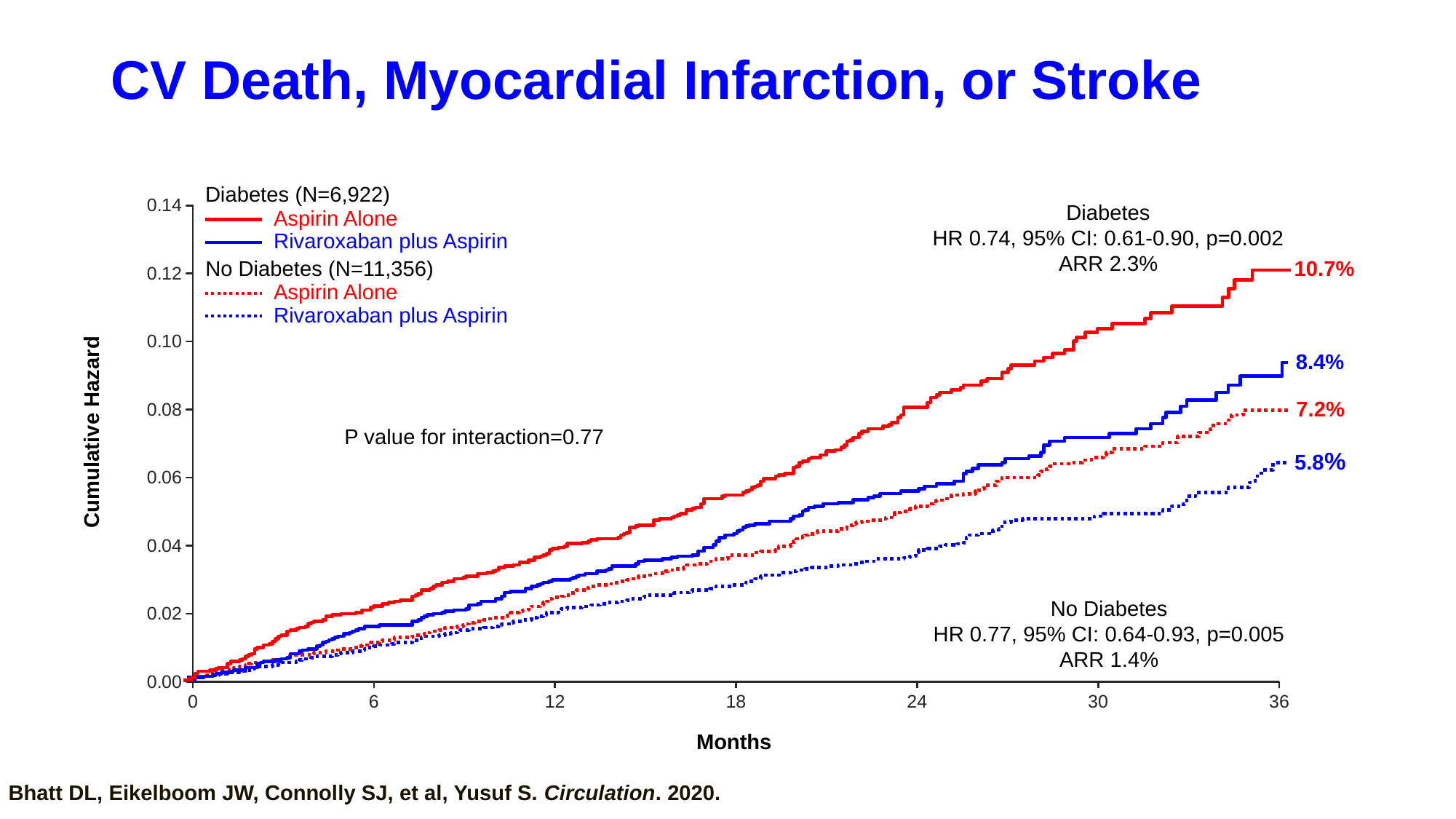
What kind of chart is shown on the slide? Line chart (cumulative hazard curves) Which curve has the highest cumulative hazard at 36 months? Diabetes, Aspirin Alone How many curves does the legend list? 4 What is the cumulative hazard at 36 months for Aspirin Alone in the Diabetes group? 10.7% What is the cumulative hazard at 36 months for Aspirin Alone in the No Diabetes group? 7.2% What is the cumulative hazard at 36 months for Rivaroxaban plus Aspirin in the Diabetes group? 8.4% What is the difference in cumulative hazard at 36 months between Aspirin Alone and Rivaroxaban plus Aspirin in the Diabetes group? 2.3% At 36 months, which is larger: the cumulative hazard for Rivaroxaban plus Aspirin in the Diabetes group or for Aspirin Alone in the No Diabetes group? Rivaroxaban plus Aspirin in the Diabetes group What is the cumulative hazard at 36 months for Rivaroxaban plus Aspirin in the No Diabetes group? 5.8% Which curve has the lowest cumulative hazard at 36 months? No Diabetes, Rivaroxaban plus Aspirin Is the cumulative hazard for the Diabetes Aspirin Alone curve at 24 months greater or less than 0.06? greater Do the cumulative hazard curves rise or fall as months increase? Rise